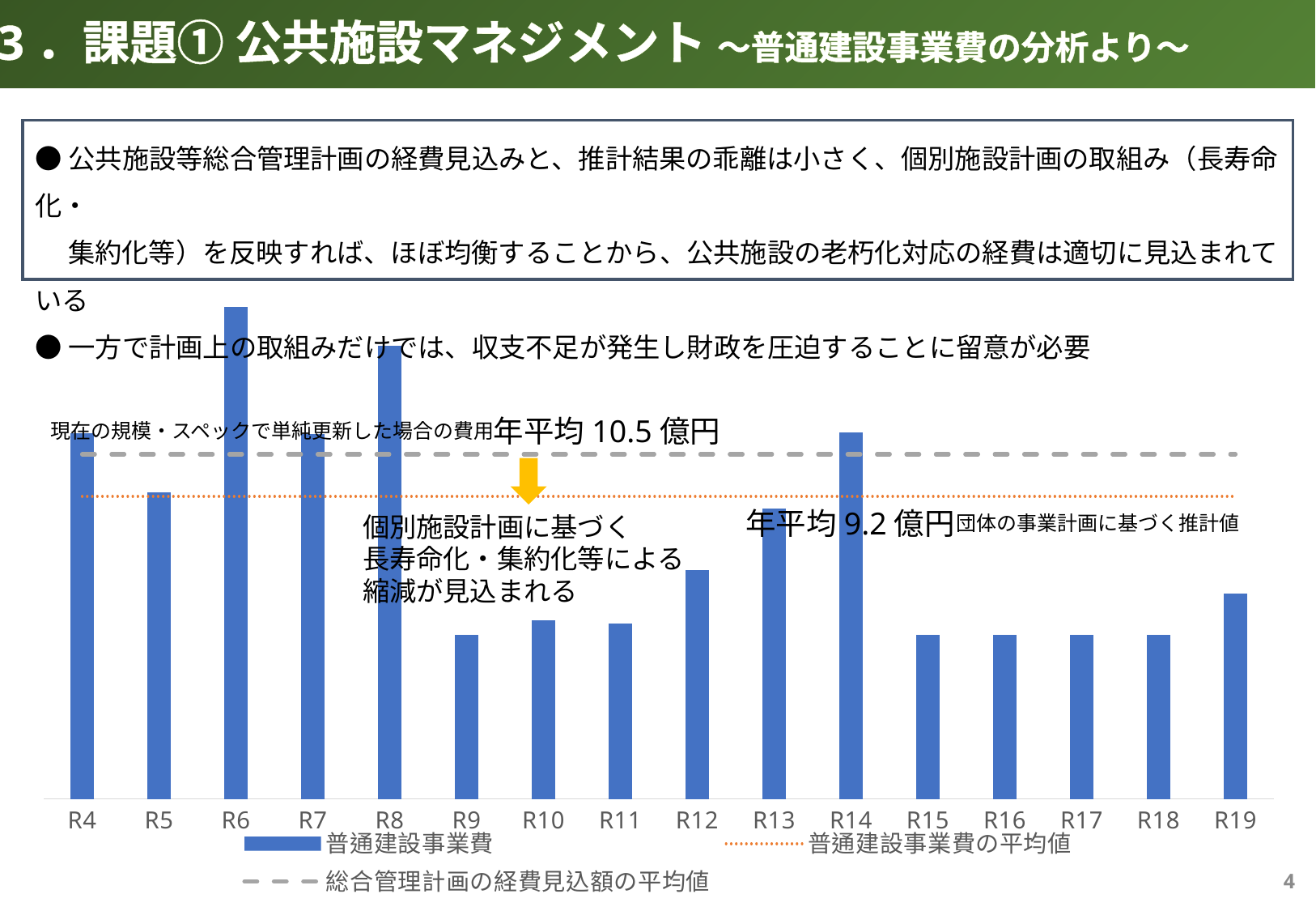
How many entries does the chart legend list? 3 Is the bar for R9 greater or less than the 9.2 億円 dotted line? less What is the difference between the annual average of 10.5 億円 and the annual average of 9.2 億円 shown on the chart? 1.3 億円 How many categories (years) are shown on the x axis of the chart? 16 Which is larger, the bar for R6 or the bar for R14? R6 Which year has the highest 普通建設事業費 bar? R6 Which is larger, the bar for R12 or the bar for R19? R12 Is the bar for R6 greater or less than the 10.5 億円 dashed line? greater What is the annual average value shown for 総合管理計画の経費見込額の平均値 (the dashed line)? 10.5 億円 What kind of chart is shown on the slide? bar chart What is the annual average value shown for 普通建設事業費の平均値 (the dotted line)? 9.2 億円